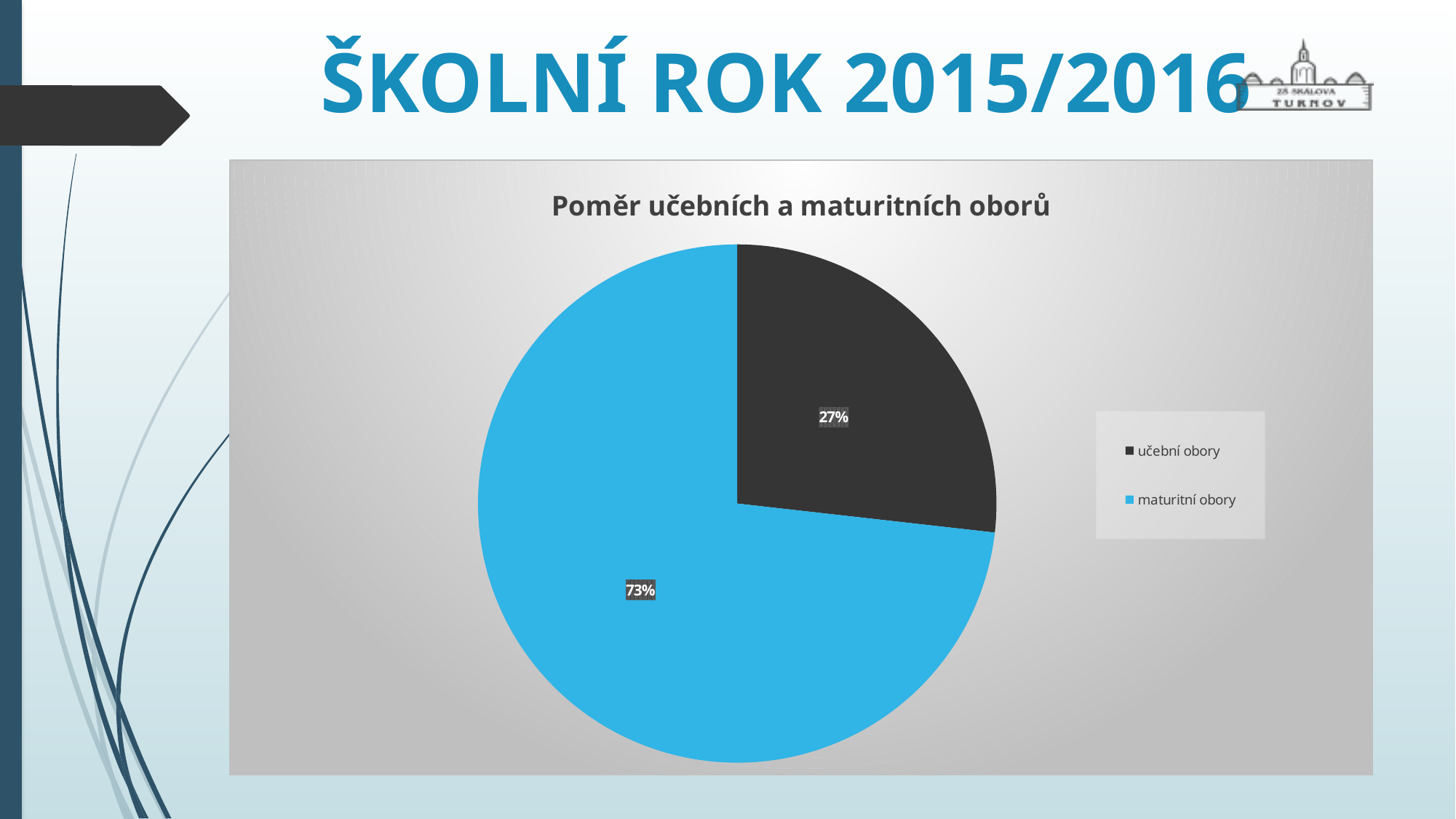
What share of the pie does 'maturitní obory' represent? 73% How many slices does the pie chart have? 2 How many entries does the legend list? 2 Which is larger, the share for 'učební obory' or the share for 'maturitní obory'? maturitní obory What colour is the slice for 'maturitní obory'? blue What is the title of the chart? Poměr učebních a maturitních oborů Which category has the largest share of the pie? maturitní obory What type of chart is shown on the slide? pie chart Which category has the smallest share of the pie? učební obory What is the difference in percentage points between 'maturitní obory' and 'učební obory'? 46 What share of the pie does 'učební obory' represent? 27%